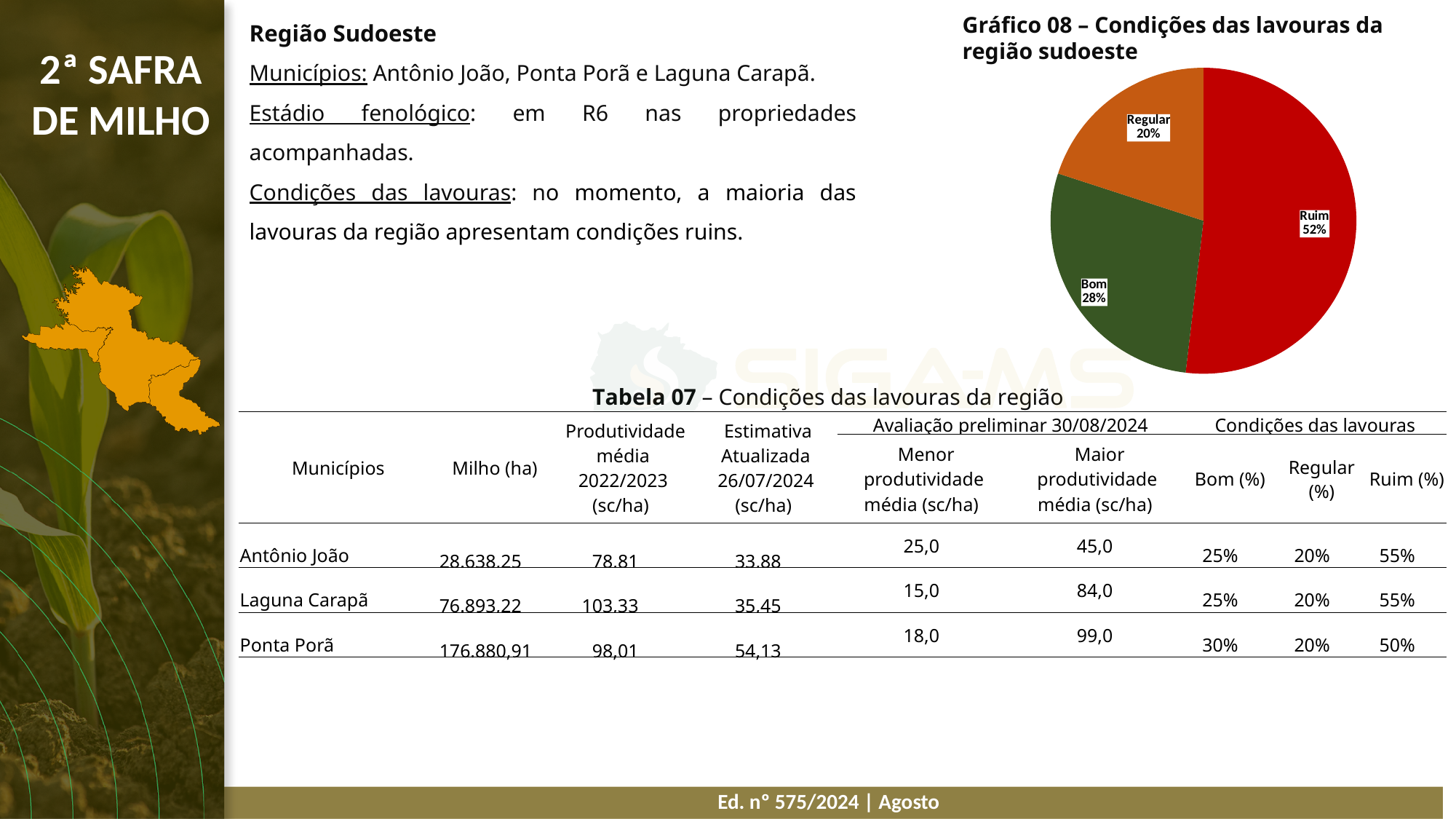
How many slices does the pie chart have? 3 What type of chart is Gráfico 08? Pie chart What colour is the Ruim slice in the pie chart? Red What is the title of the pie chart? Gráfico 08 – Condições das lavouras da região sudoeste What is the difference in percentage points between the Bom and Regular slices? 8 What share of the pie does the Bom slice represent? 28% What is the difference in percentage points between the Ruim and Bom slices? 24 Which slice is larger, Bom or Regular? Bom What share of the pie does the Regular slice represent? 20% Which category has the smallest slice in the pie chart? Regular What share of the pie does the Ruim slice represent? 52% Which category has the largest slice in the pie chart? Ruim